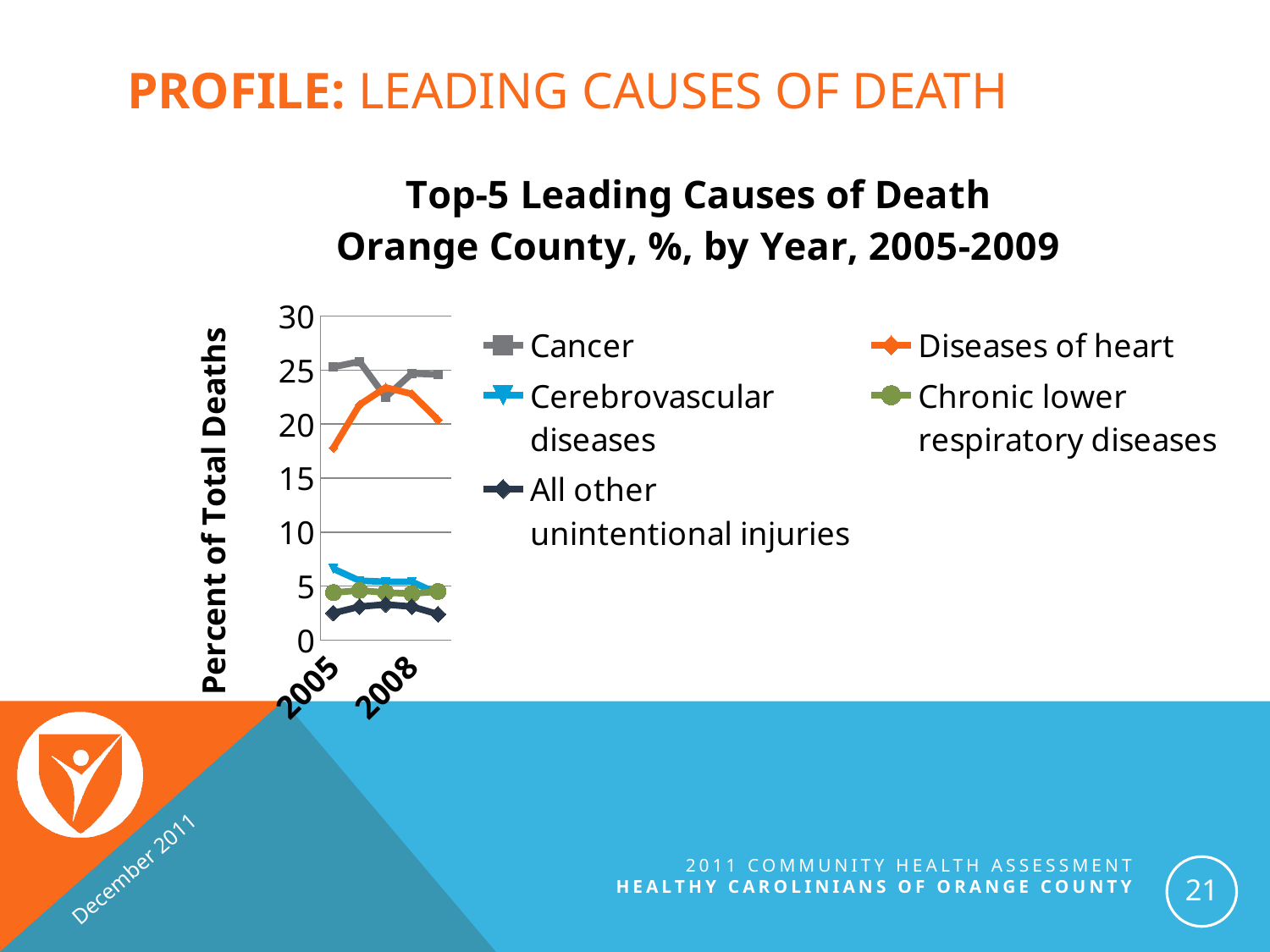
Which cause of death has the highest percent of total deaths in 2005? Cancer What is the title of the chart? Top-5 Leading Causes of Death Orange County, %, by Year, 2005-2009 How many years are plotted on the x axis of the chart? 5 In 2005, which is larger: the value for Cancer or the value for Diseases of heart? Cancer Does the value for Diseases of heart rise or fall from 2005 to 2007? rise What is the label on the vertical axis of the chart? Percent of Total Deaths Is the value for Cancer in 2005 greater or less than 20? greater Is the value for Cerebrovascular diseases in 2005 greater or less than 5? greater Which cause of death has the lowest percent of total deaths in 2005? All other unintentional injuries Is the value for Diseases of heart in 2005 greater or less than 20? less How many series does the legend list? 5 What kind of chart is shown on the slide? line chart